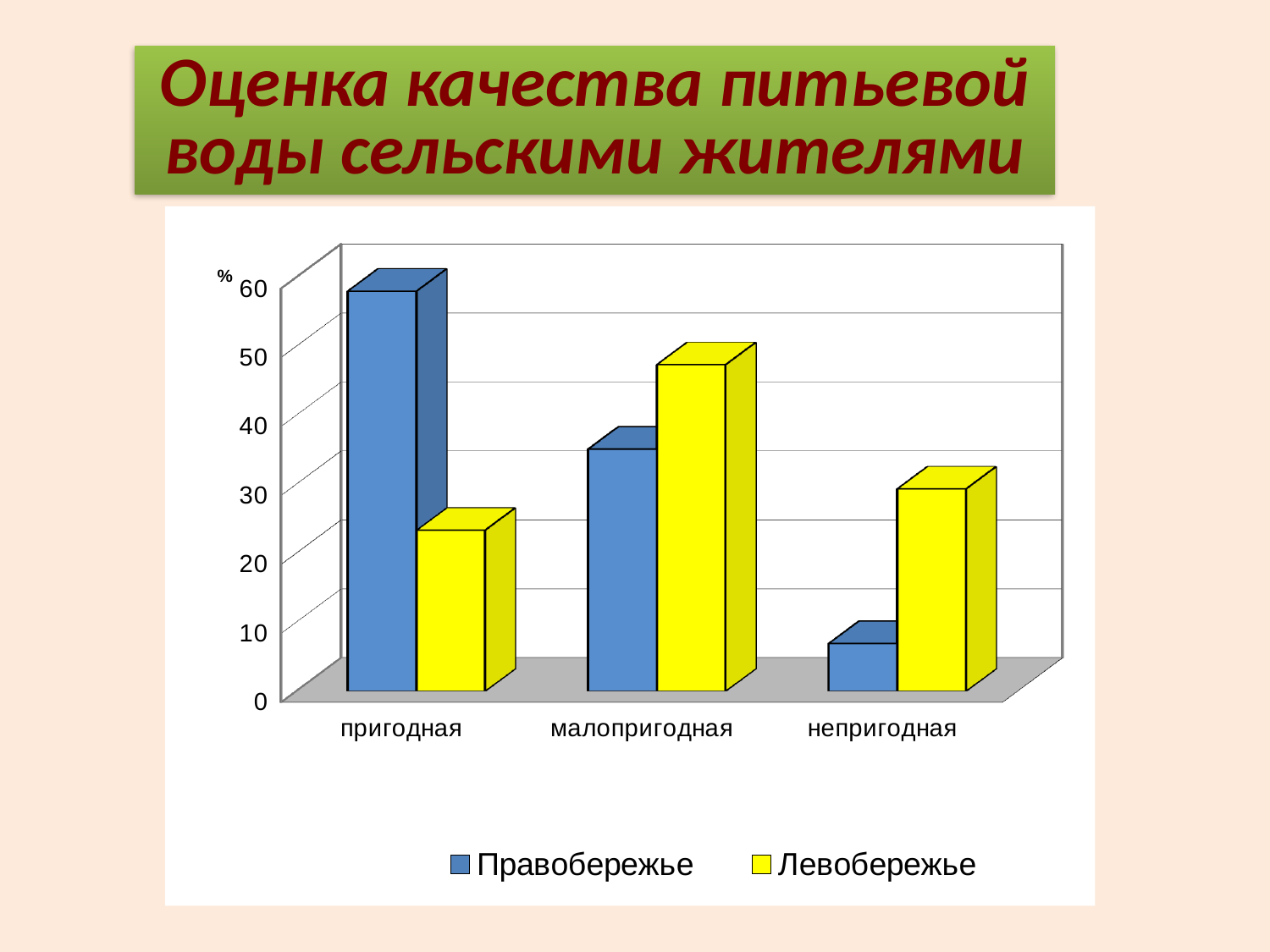
Which category has the highest value for Правобережье? пригодная What kind of chart is shown on the slide? bar chart For the category непригодная, which series has the larger value, Правобережье or Левобережье? Левобережье How many categories are shown on the x axis of the chart? 3 Is the value for Левобережье in the category пригодная greater or less than 30? less Do the values for Правобережье rise or fall from пригодная to непригодная along the x axis? fall How many series does the chart's legend list? 2 For the category пригодная, which series has the larger value, Правобережье or Левобережье? Правобережье Which category has the lowest value for Левобережье? пригодная Is the value for Правобережье in the category пригодная greater or less than 50? greater Which category has the highest value for Левобережье? малопригодная Which category has the lowest value for Правобережье? непригодная